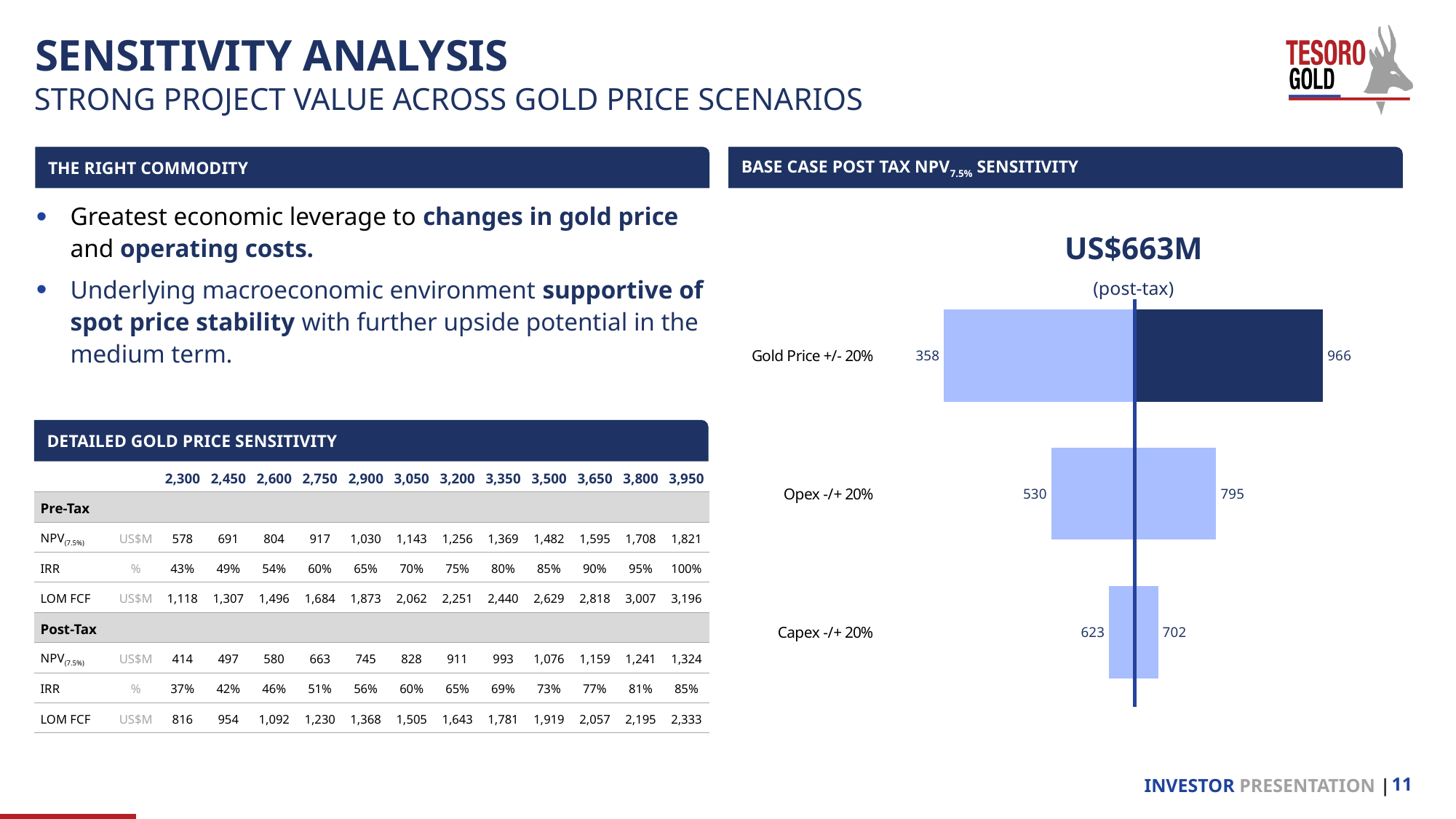
What base case post-tax NPV value is shown above the sensitivity chart? US$663M In the sensitivity chart, which is larger: the high-side value for Opex -/+ 20% or the high-side value for Capex -/+ 20%? Opex -/+ 20% In the sensitivity chart, which category has the widest range of NPV outcomes? Gold Price +/- 20% In the sensitivity chart, what is the difference between the high and low values for Opex -/+ 20%? 265 How many categories are shown in the sensitivity chart? 3 In the sensitivity chart, what is the high-side value for Gold Price +/- 20%? 966 In the sensitivity chart, what is the low-side value for Gold Price +/- 20%? 358 In the sensitivity chart, which category has the narrowest range of NPV outcomes? Capex -/+ 20% In the sensitivity chart, what is the high-side value for Capex -/+ 20%? 702 What kind of chart is shown under 'Base Case Post Tax NPV7.5% Sensitivity'? Bar chart In the sensitivity chart, what is the difference between the high and low values for Gold Price +/- 20%? 608 In the sensitivity chart, what is the low-side value for Opex -/+ 20%? 530